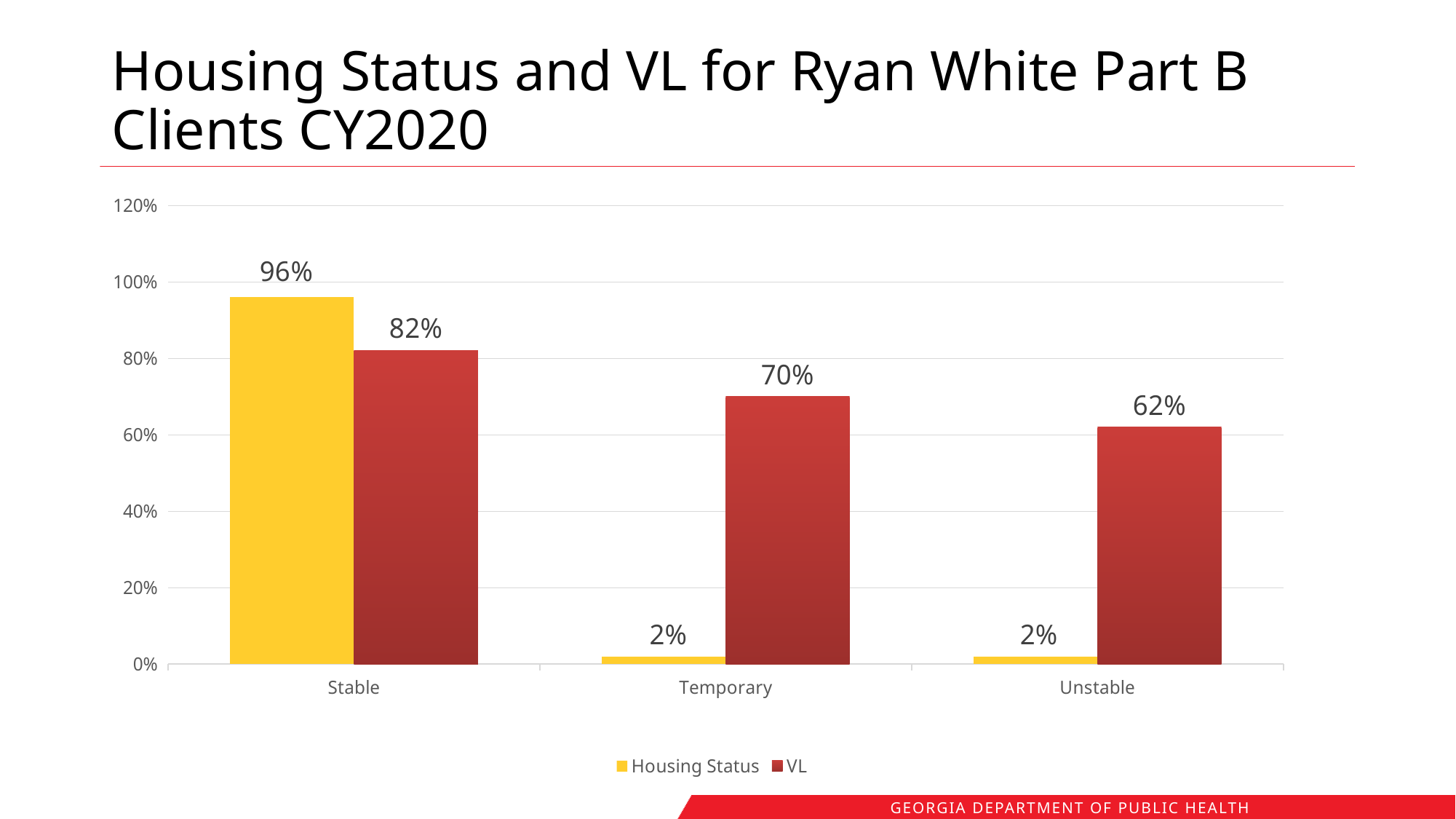
What is the difference between the Housing Status and VL values for Stable? 14% What is the VL value for Temporary? 70% What kind of chart is shown on the slide? Bar chart Which housing category has the highest VL value? Stable What is the Housing Status value for Temporary? 2% Which is larger, the VL value for Stable or the VL value for Temporary? Stable What is the difference between the VL values for Temporary and Unstable? 8% Which housing category has the lowest VL value? Unstable What is the VL value for Unstable? 62% How many series does the legend list? 2 How many housing categories are shown on the x axis? 3 What is the Housing Status value for Stable? 96%